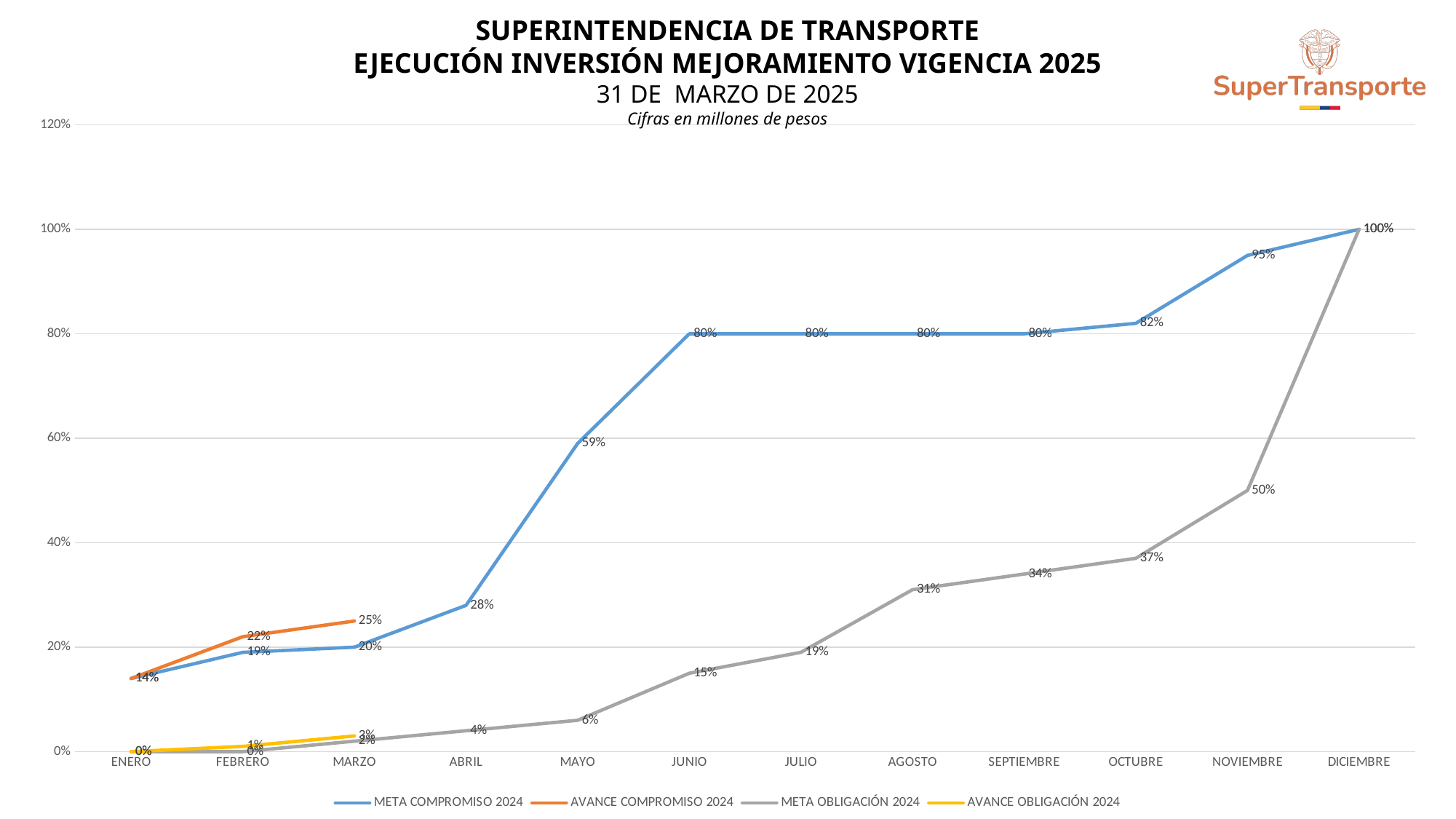
In MARZO, which is higher: AVANCE COMPROMISO 2024 or META COMPROMISO 2024? AVANCE COMPROMISO 2024 What is the value of META OBLIGACIÓN 2024 in NOVIEMBRE? 50% What is the value of AVANCE OBLIGACIÓN 2024 in FEBRERO? 1% In which month does META OBLIGACIÓN 2024 reach its highest value? DICIEMBRE What is the value of META OBLIGACIÓN 2024 in AGOSTO? 31% How many months are shown along the x axis? 12 Does META COMPROMISO 2024 generally rise or fall from ENERO to DICIEMBRE? Rise By how many percentage points does META COMPROMISO 2024 increase from ABRIL to MAYO? 31 percentage points How many series does the legend list? 4 What is the value of META COMPROMISO 2024 in MAYO? 59% What is the value of AVANCE COMPROMISO 2024 in MARZO? 25% What kind of chart is shown on the slide? Line chart